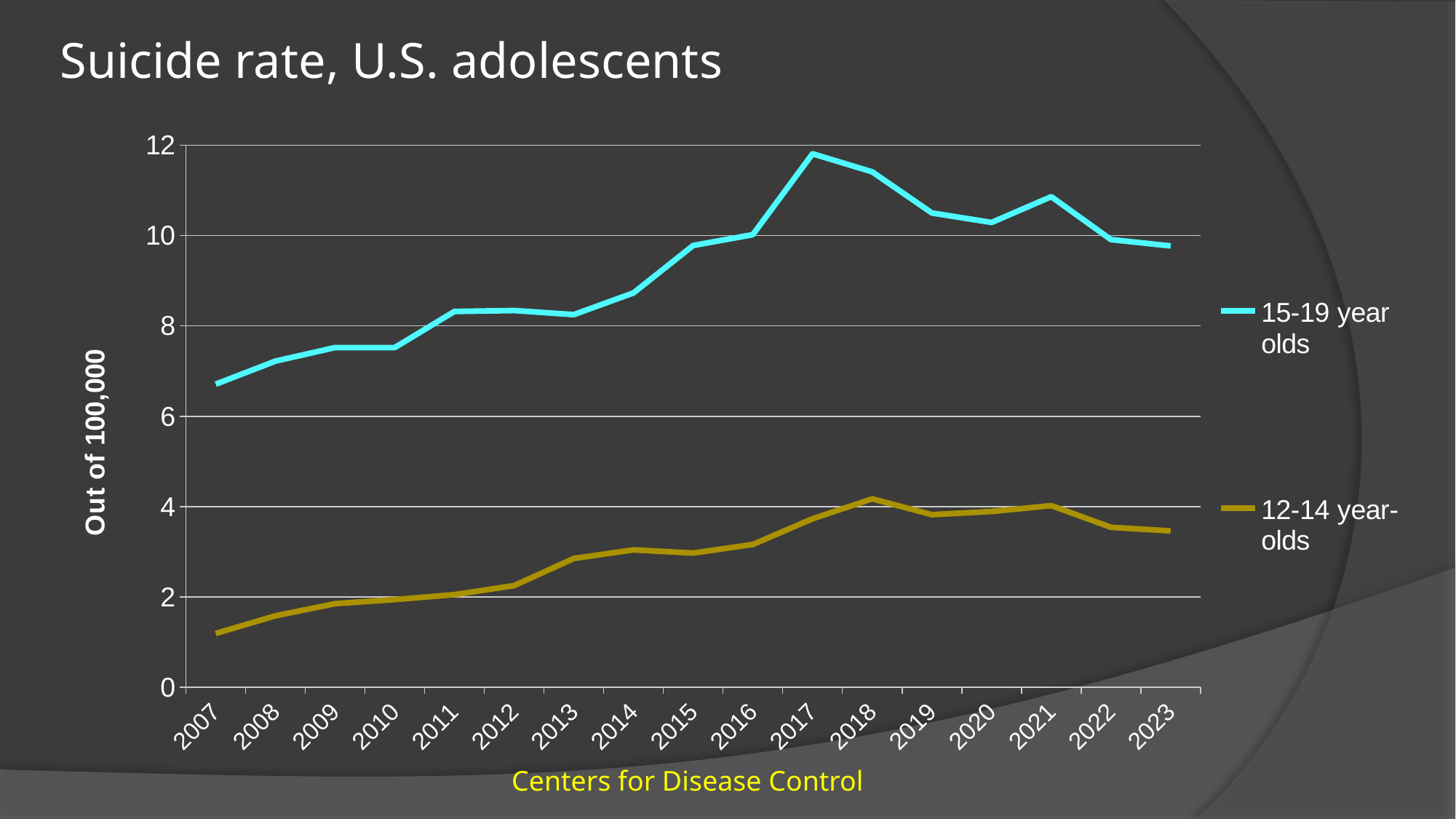
Is the value for 15-19 year olds in 2017 greater or less than 10? greater In which year is the suicide rate for 12-14 year-olds lowest? 2007 Which series has the higher value in 2019, 15-19 year olds or 12-14 year-olds? 15-19 year olds What kind of chart is shown on the slide? line chart In which year is the suicide rate for 15-19 year olds lowest? 2007 Is the value for 15-19 year olds in 2021 greater or less than 10? greater Does the suicide rate for 15-19 year olds rise or fall from 2007 to 2017? rise What is the label on the vertical axis? Out of 100,000 Is the value for 12-14 year-olds in 2007 greater or less than 2? less How many series does the legend list? 2 How many years are plotted along the x axis? 17 In which year is the suicide rate for 15-19 year olds highest? 2017